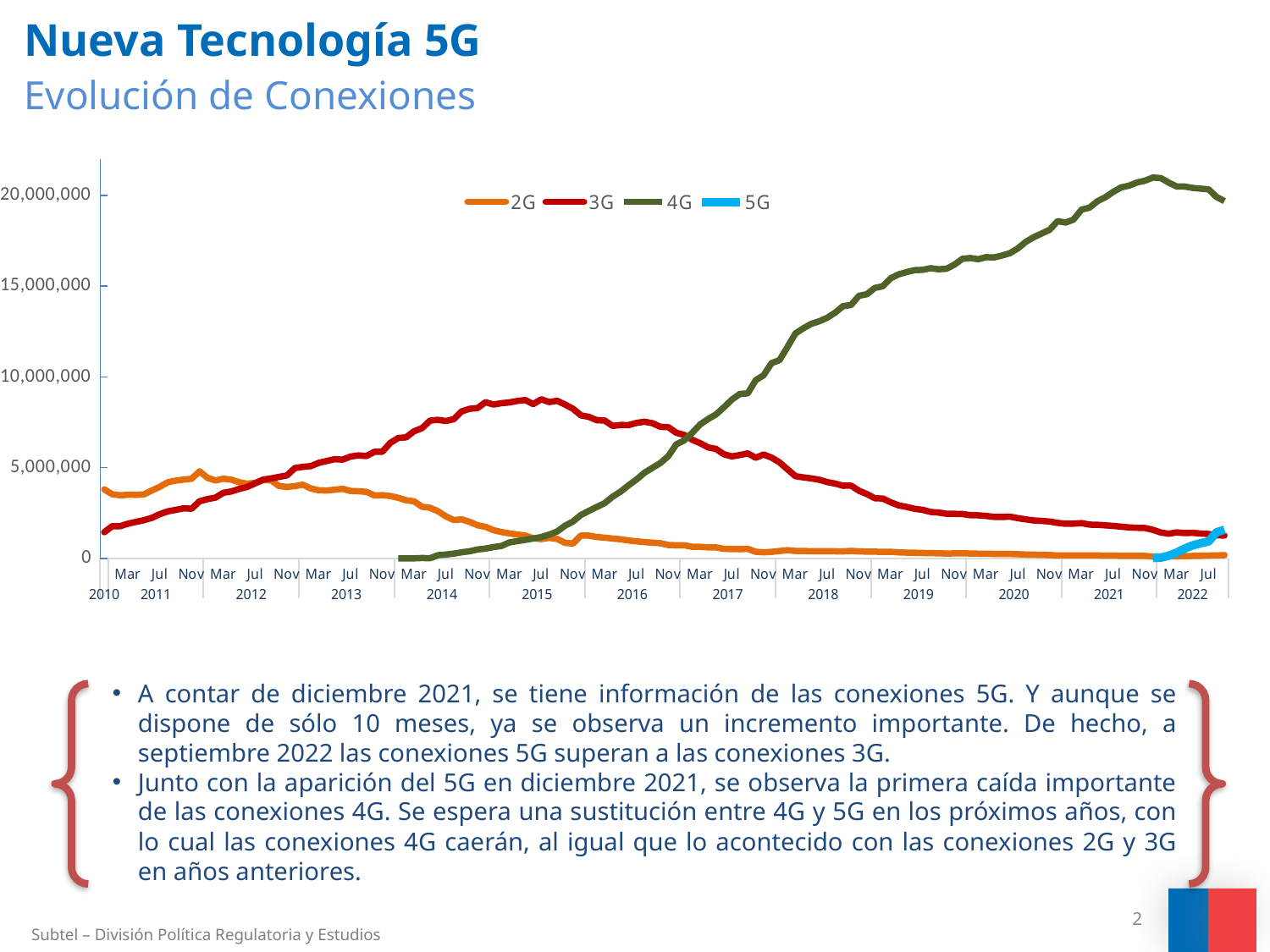
Does the 3G line rise or fall from 2016 to 2022? fall Which series has the higher value in 2022, 3G or 4G? 4G What kind of chart is shown on the slide? line chart Which series has the higher value at the start of 2010, 2G or 3G? 2G Is the peak value of the 3G line (around 2015) greater or less than 10,000,000? less Is the value of the 4G line at the end of 2019 greater or less than 15,000,000? greater Does the 4G line rise or fall from 2014 to 2021? rise Is the peak value of the 4G line greater or less than 20,000,000? greater How many series does the chart legend list? 4 What colour is the 5G line in the chart? light blue Which series are listed in the chart legend? 2G, 3G, 4G, 5G